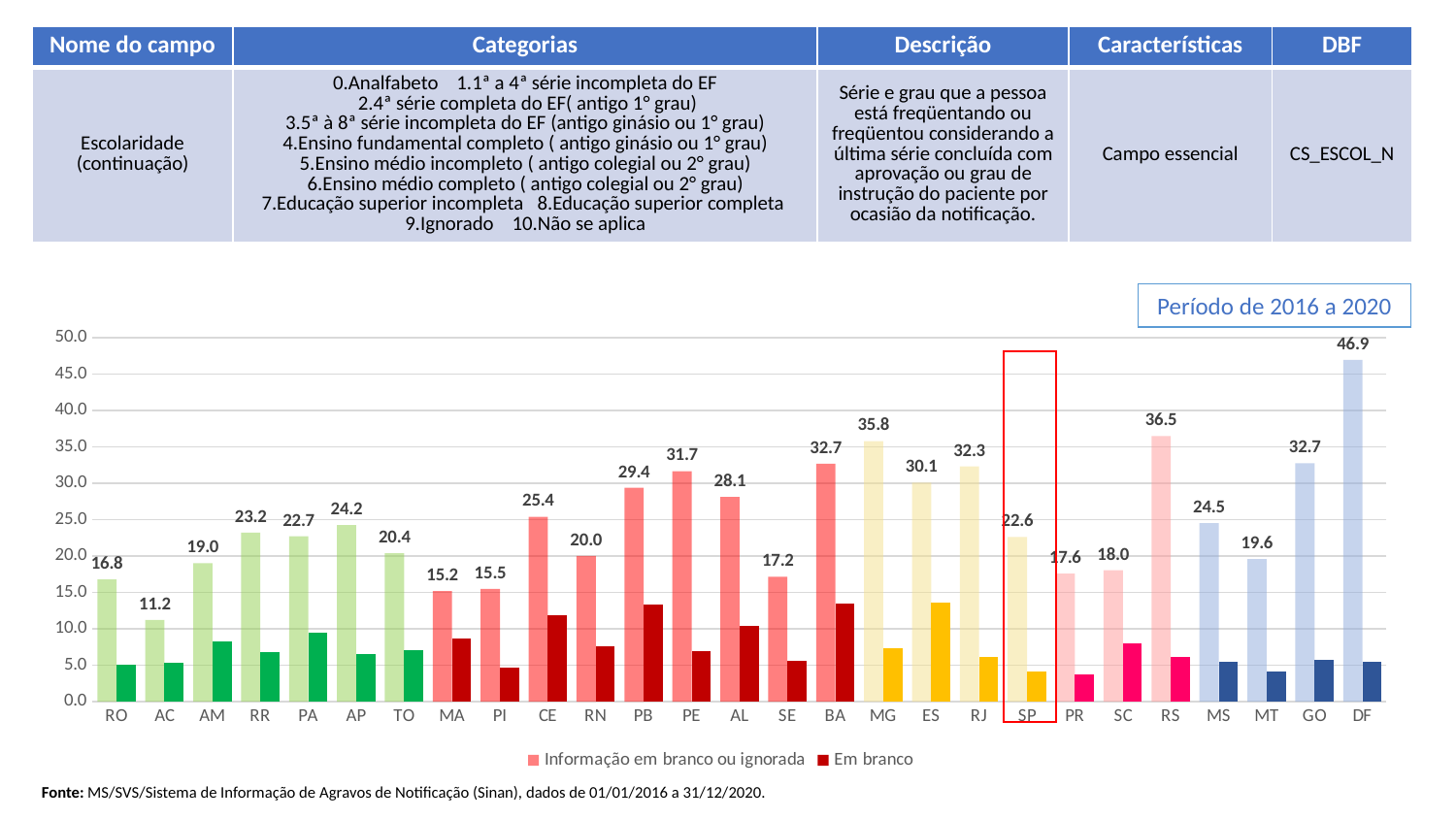
What kind of chart is shown on the slide? Bar chart How many series does the legend list? 2 Which state has the lowest value for 'Informação em branco ou ignorada'? AC How many states are shown on the x axis of the chart? 27 What is the value of 'Informação em branco ou ignorada' for DF? 46.9 What period does the chart cover, according to the box above it? Período de 2016 a 2020 Is the 'Em branco' value for PR greater or less than 5.0? less What is the difference between the 'Informação em branco ou ignorada' values for DF and RS? 10.4 What is the value of 'Informação em branco ou ignorada' for SP? 22.6 Is the 'Em branco' value for ES greater or less than 10.0? greater Which state has the highest value for 'Informação em branco ou ignorada'? DF Which has a larger 'Informação em branco ou ignorada' value, PE or PB? PE